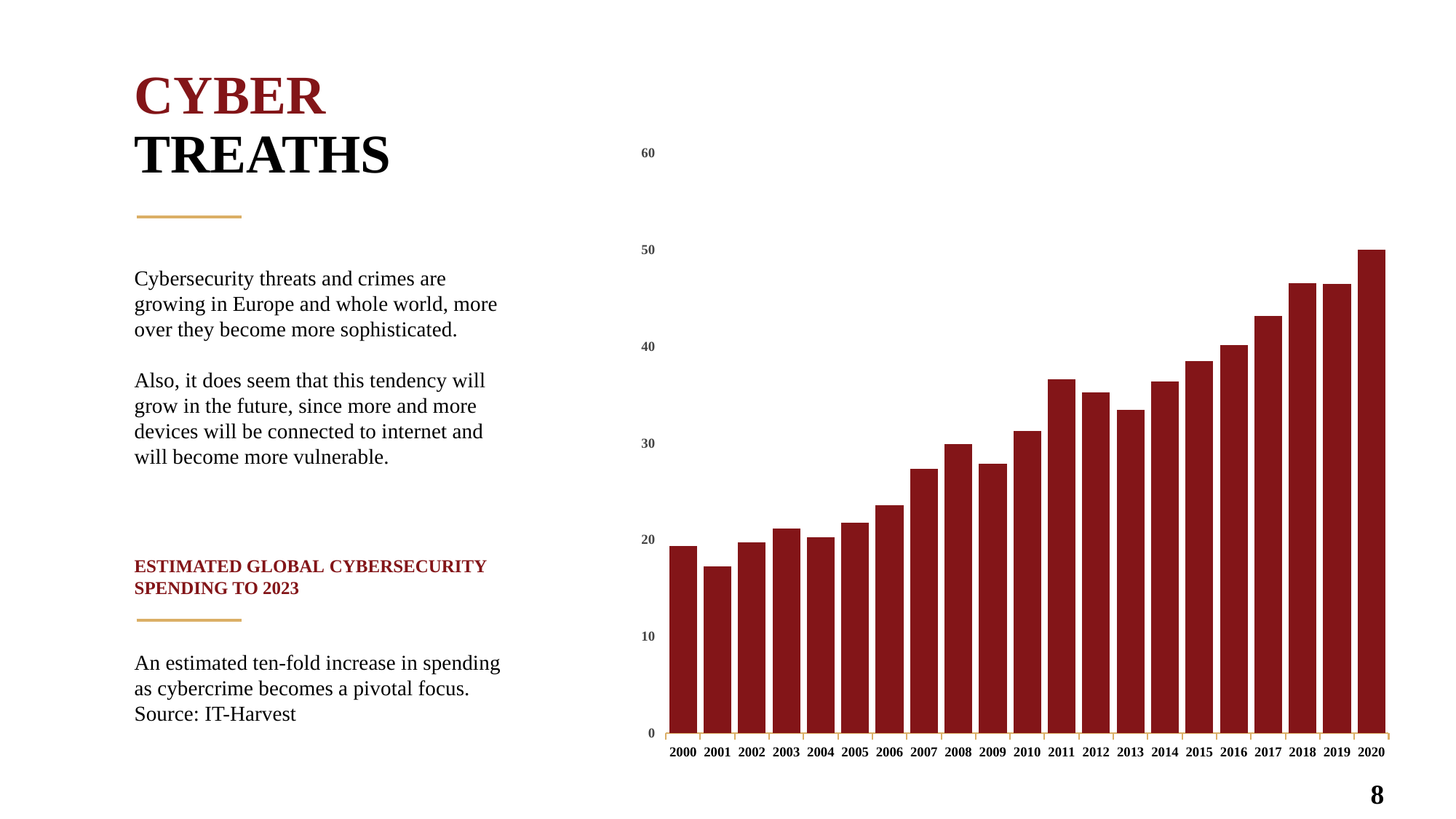
Which year has the lowest bar on the chart? 2001 Which year has the larger value, 2006 or 2010? 2010 Is the value for 2013 greater or less than 30? greater Is the value for 2020 greater or less than 40? greater What kind of chart is shown on the slide? bar chart Which year has the highest bar on the chart? 2020 Which year has the larger value, 2011 or 2013? 2011 How many years (bars) are plotted on the chart? 21 Is the value for 2011 greater or less than 40? less Overall, do the values rise or fall from 2000 to 2020? rise What is the title given for the chart on the slide? ESTIMATED GLOBAL CYBERSECURITY SPENDING TO 2023